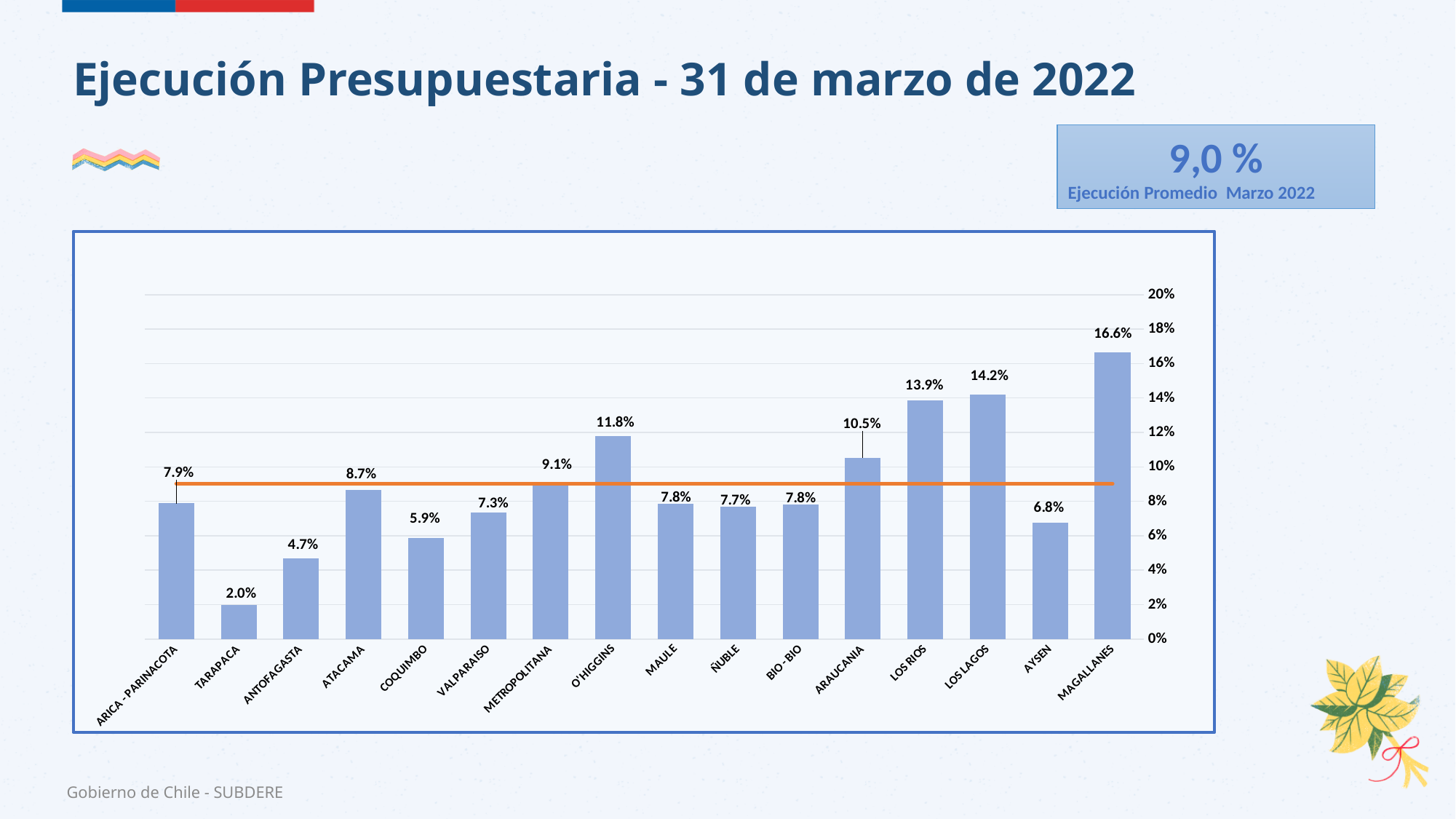
Which region has the highest value? MAGALLANES Which region has the lowest value? TARAPACA What value does the box in the top right give for Ejecución Promedio Marzo 2022? 9,0 % How many regions are shown on the x axis? 16 What is the value for MAGALLANES? 16.6% What is the difference between the values for LOS LAGOS and LOS RIOS? 0.3% What kind of chart is shown on the slide? Bar chart What is the difference between the values for MAGALLANES and TARAPACA? 14.6% What is the value for COQUIMBO? 5.9% What is the value for TARAPACA? 2.0% Which is larger, the value for ARAUCANIA or the value for ATACAMA? ARAUCANIA What is the value for O'HIGGINS? 11.8%